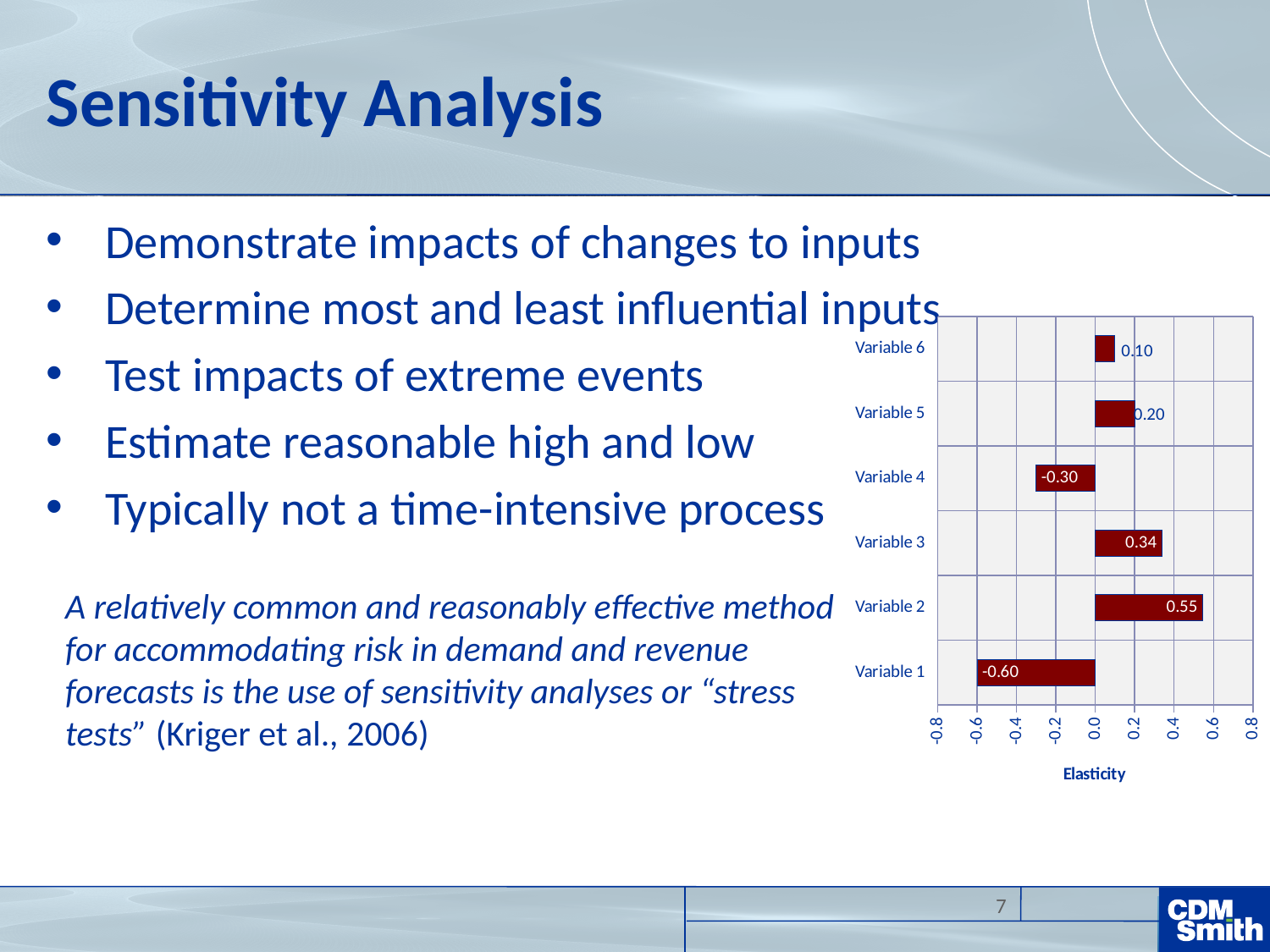
What kind of chart is shown on the slide? Bar chart What is the elasticity value for Variable 3? 0.34 What is the elasticity value for Variable 2? 0.55 Which has a larger elasticity value, Variable 5 or Variable 6? Variable 5 What is the difference between the elasticity values of Variable 2 and Variable 3? 0.21 Which variable has the lowest elasticity value? Variable 1 What is the elasticity value for Variable 4? -0.30 How many variables are shown in the chart? 6 What is the label of the horizontal axis of the chart? Elasticity What is the elasticity value for Variable 1? -0.60 Which variable has the highest elasticity value? Variable 2 How many variables have a negative elasticity value? 2